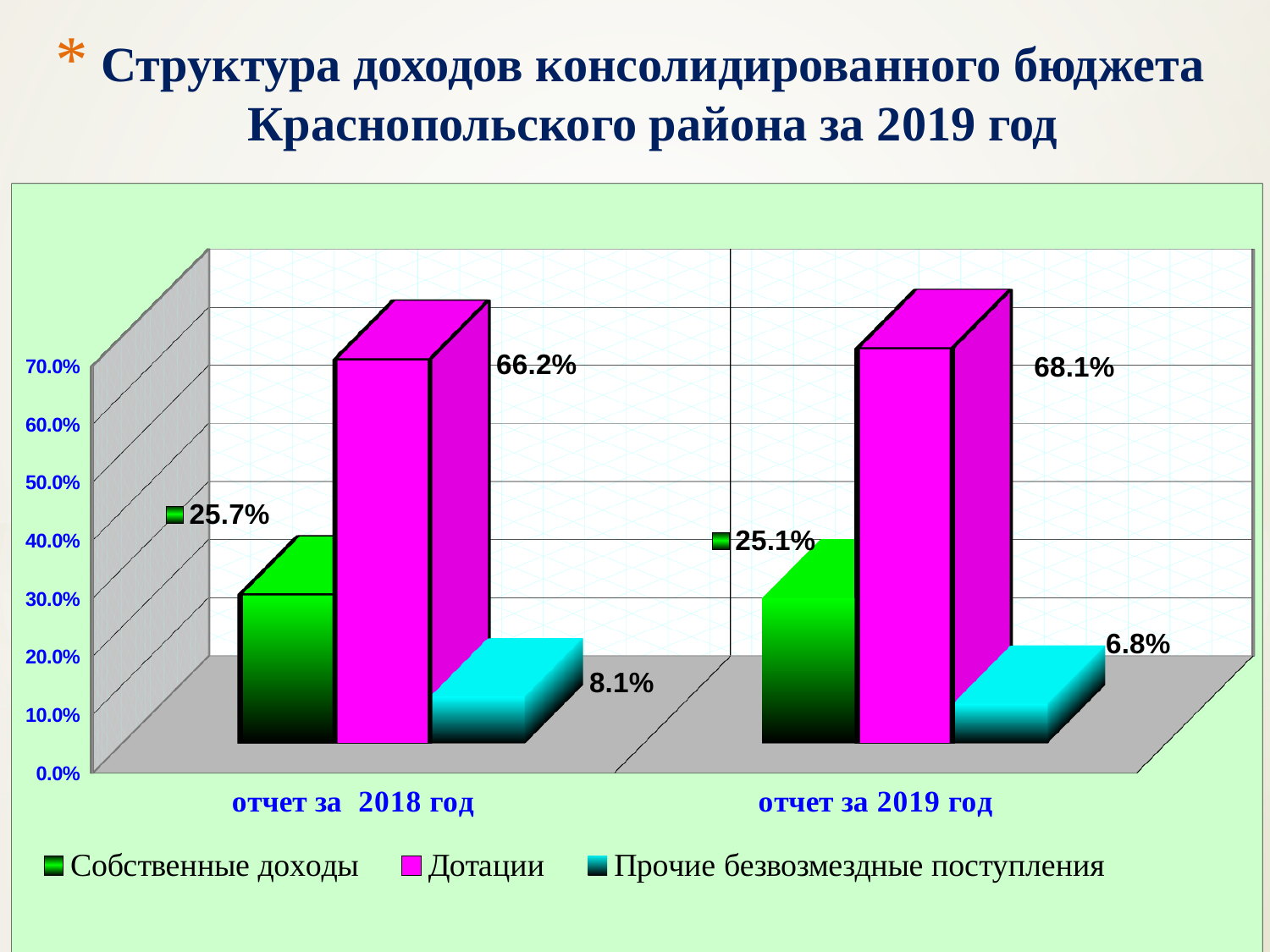
Which series has the highest value for отчет за 2019 год? Дотации What is the value of Прочие безвозмездные поступления for отчет за 2019 год? 6.8% What kind of chart is shown on the slide? bar chart What is the value of Дотации for отчет за 2018 год? 66.2% How many categories are shown on the x axis? 2 What is the value of Собственные доходы for отчет за 2018 год? 25.7% What is the difference between the Дотации values for отчет за 2019 год and отчет за 2018 год? 1.9% Which series has the lowest value for отчет за 2018 год? Прочие безвозмездные поступления Which colour represents Дотации in the chart? magenta What is the value of Дотации for отчет за 2019 год? 68.1% Which is larger: Собственные доходы for отчет за 2018 год or for отчет за 2019 год? отчет за 2018 год How many series does the legend list? 3